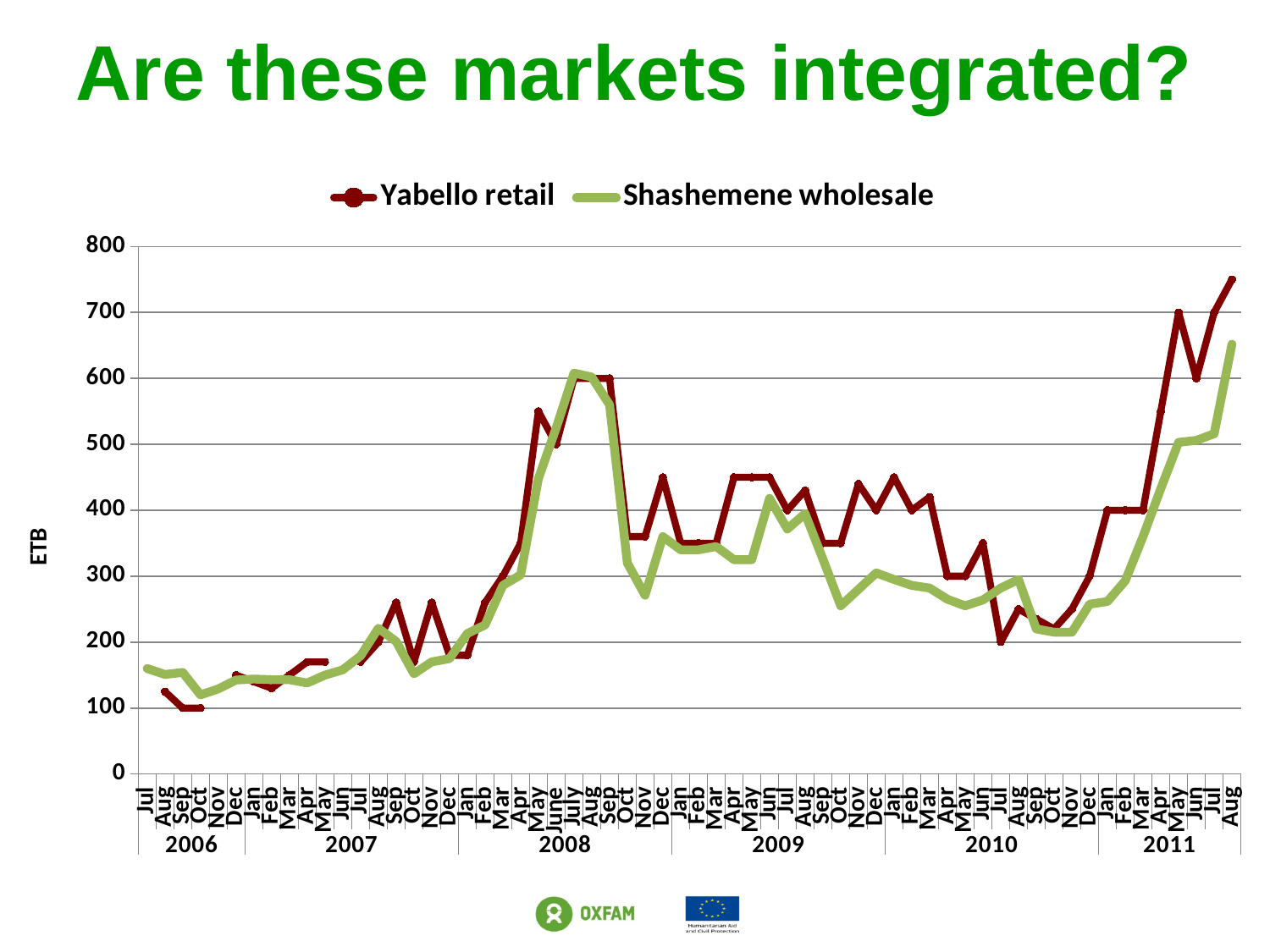
Is the value for Shashemene wholesale in Jul 2008 greater or less than 500? greater What kind of chart is shown on the slide? line chart Which series reaches the highest value anywhere on the chart? Yabello retail In Aug 2011, which series has the higher value, Yabello retail or Shashemene wholesale? Yabello retail What is the label on the vertical axis? ETB Is the value for Shashemene wholesale in Aug 2011 greater or less than 600? greater In Nov 2008, which series has the higher value, Yabello retail or Shashemene wholesale? Yabello retail From Jan 2011 to Aug 2011, does the Yabello retail line rise or fall? rise Is the value for Yabello retail in Aug 2011 greater or less than 700? greater What are the two series named in the legend? Yabello retail and Shashemene wholesale How many series does the legend list? 2